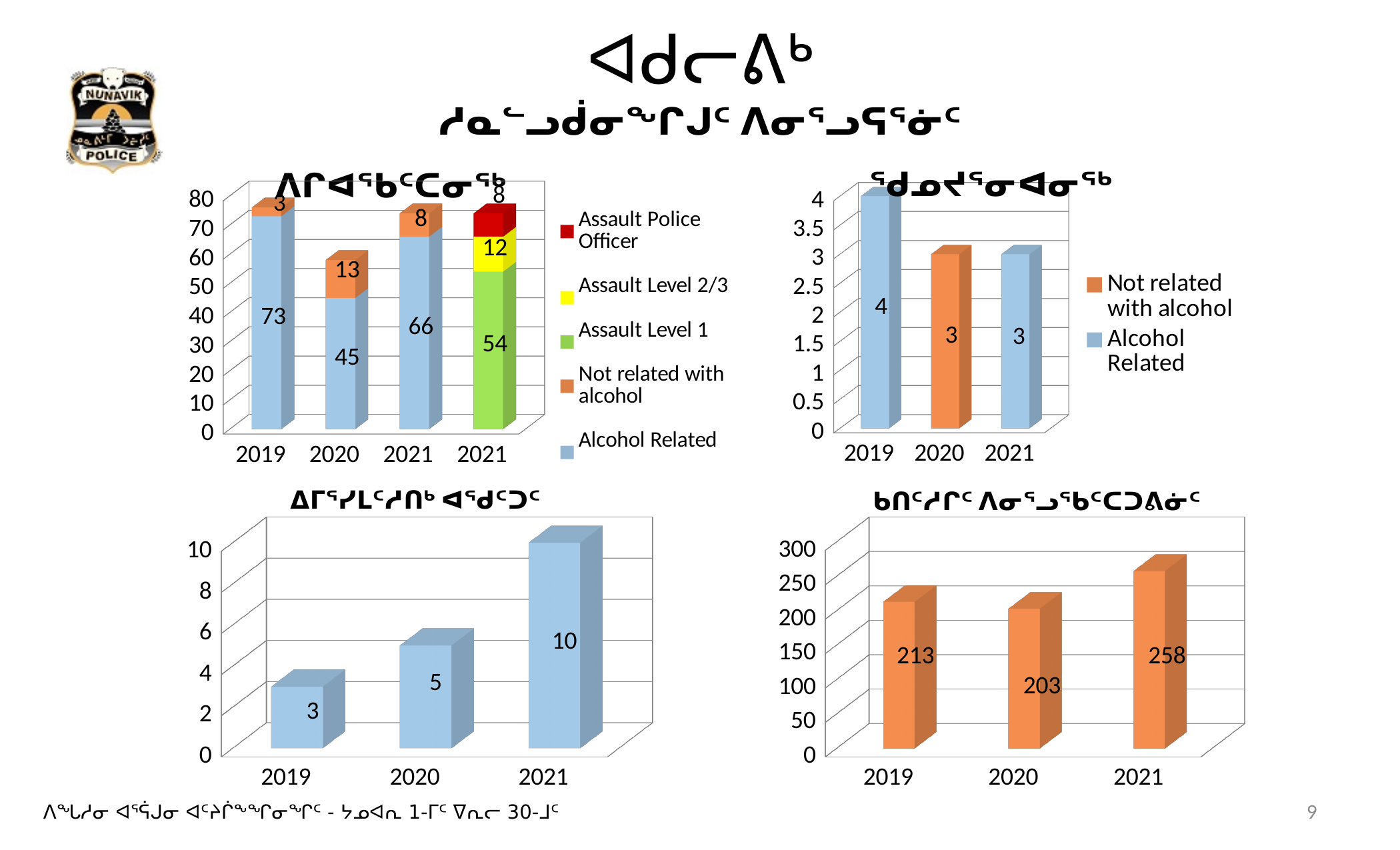
In the top-right chart, which legend entry is shown in orange? Not related with alcohol In the top-right chart, what is the value for 2019? 4 In the top-left chart, what is the Not related with alcohol value for 2020? 13 In the bottom-right chart, which year has the lowest value? 2020 How many entries does the legend of the top-left chart list? 5 In the bottom-left chart, what is the value for 2021? 10 In the top-left chart, what is the total of the stacked bar for the first 2021 category (Alcohol Related plus Not related with alcohol)? 74 In the top-left chart, what is the Alcohol Related value for 2019? 73 In the bottom-left chart, do the values rise or fall from 2019 to 2021? rise In the top-right chart, which year has the highest value? 2019 In the top-left chart, what is the Assault Level 1 value for the second 2021 bar? 54 In the bottom-right chart, what is the difference between the 2021 value and the 2020 value? 55